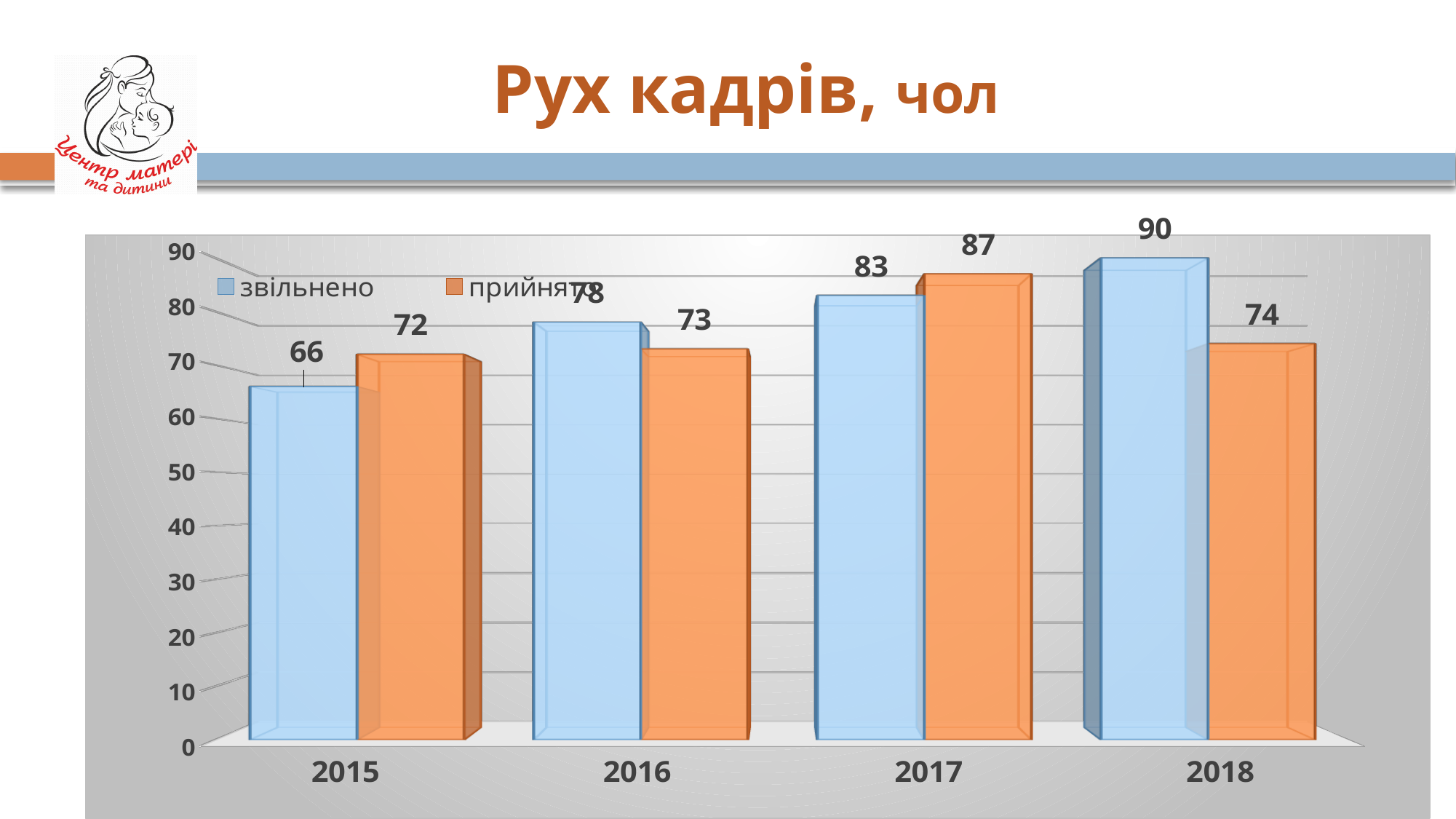
What is the value for звільнено in 2018? 90 Does the value for звільнено rise or fall from 2015 to 2018? rise In which year is the value for прийнято lowest? 2015 Which is larger in 2016, звільнено or прийнято? звільнено What colour are the bars for the прийнято series? orange How many series does the legend list? 2 What is the value for прийнято in 2017? 87 What is the difference between звільнено and прийнято in 2018? 16 In which year is the value for звільнено highest? 2018 What is the value for звільнено in 2015? 66 What type of chart is shown on the slide? bar chart How many years are shown on the x axis? 4